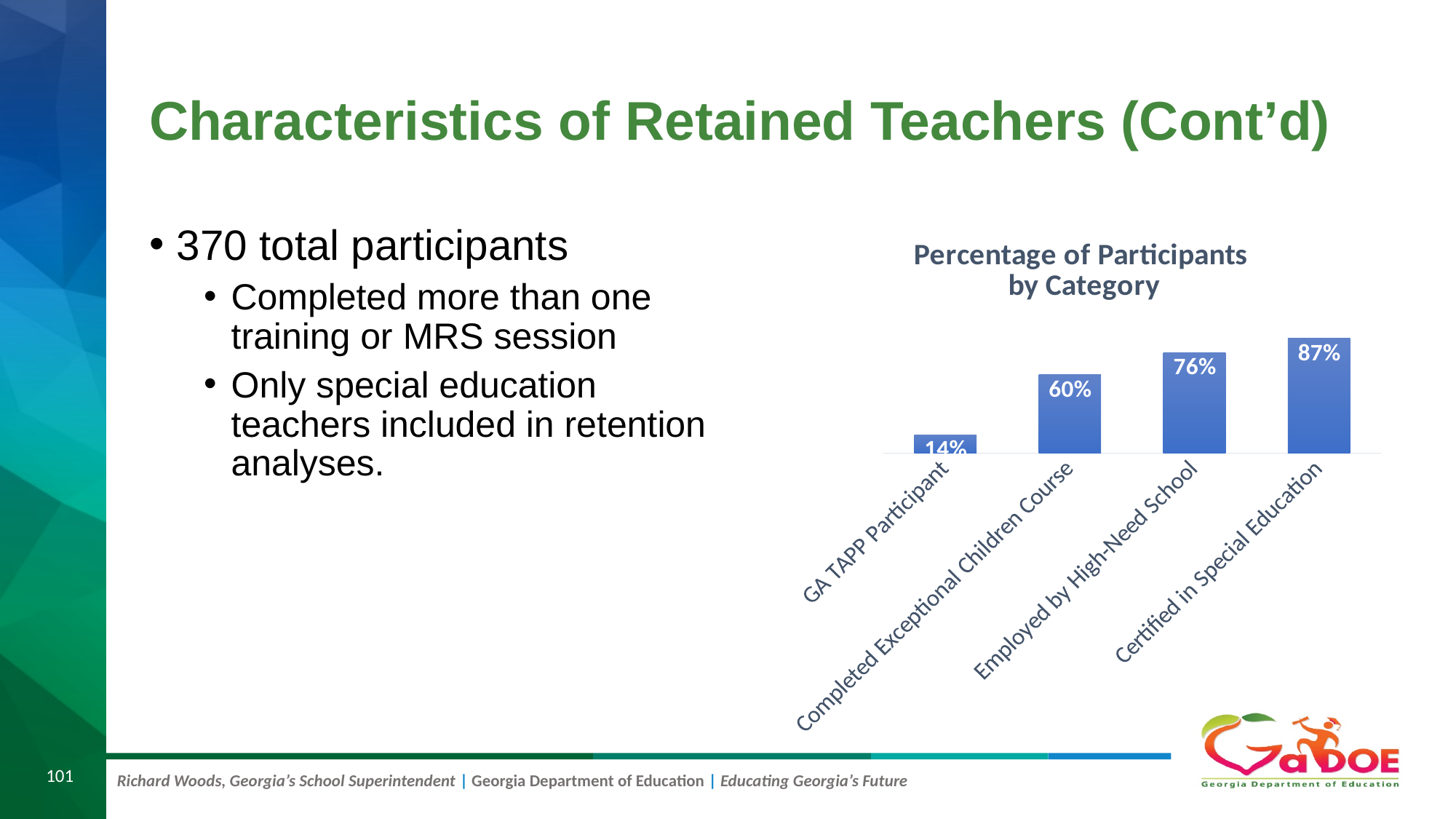
What is the value for Employed by High-Need School? 76% Which category has the highest percentage? Certified in Special Education How many categories are shown in the chart? 4 What is the value for GA TAPP Participant? 14% What is the difference between Employed by High-Need School and Completed Exceptional Children Course? 16% What is the title of the chart? Percentage of Participants by Category Which category has the lowest percentage? GA TAPP Participant Which is larger, Employed by High-Need School or Completed Exceptional Children Course? Employed by High-Need School What is the difference between Certified in Special Education and GA TAPP Participant? 73% What kind of chart is shown on the slide? Bar chart What is the value for Completed Exceptional Children Course? 60% What is the value for Certified in Special Education? 87%